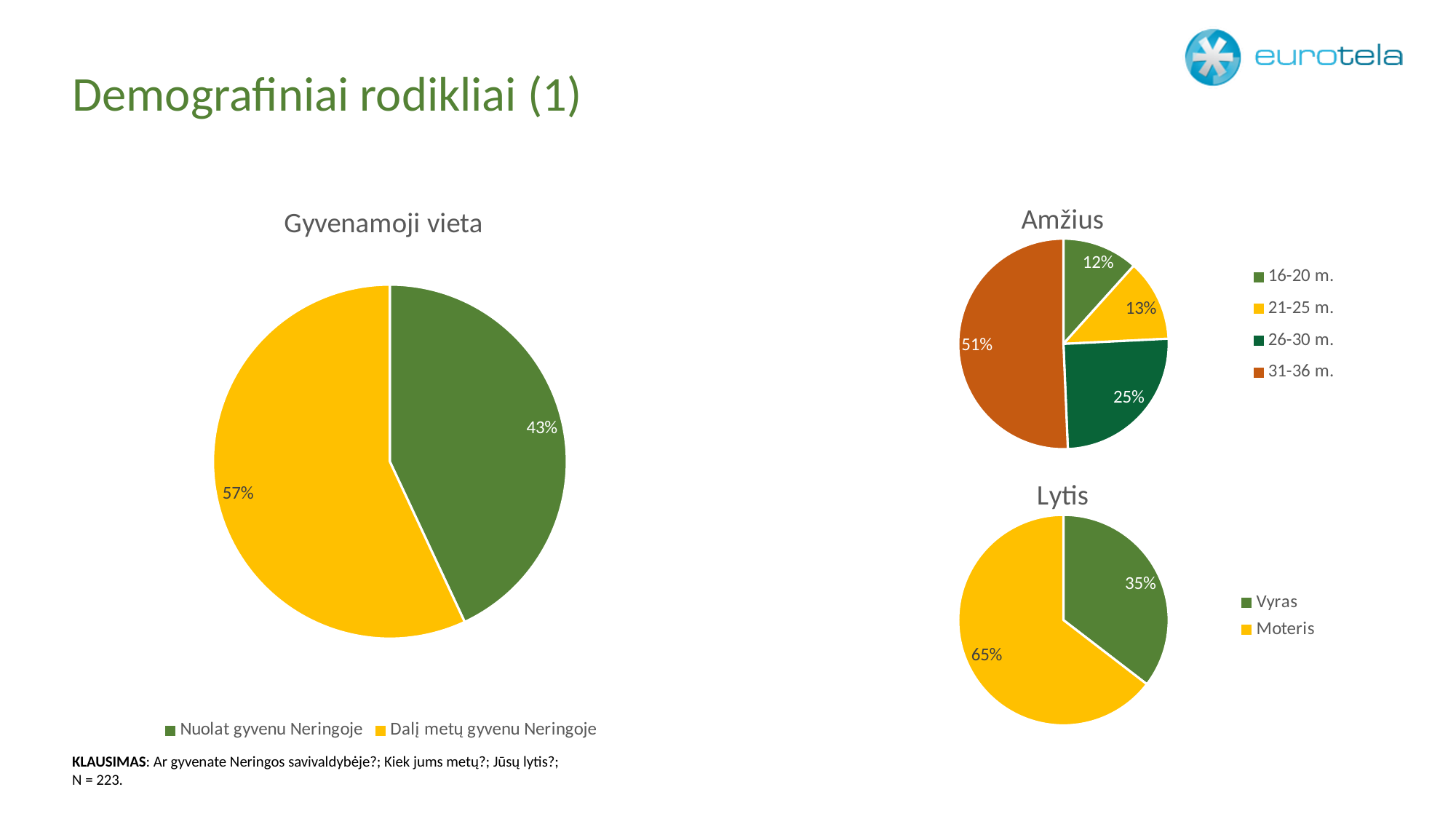
In the 'Gyvenamoji vieta' chart, what is the difference between the two slices' percentages? 14% In the 'Amžius' chart, which age group has the largest share? 31-36 m. In the 'Amžius' chart, what share is labelled for '26-30 m.'? 25% In the 'Lytis' chart, what share is labelled for 'Moteris'? 65% In the 'Gyvenamoji vieta' chart, what share is labelled for 'Dalį metų gyvenu Neringoje'? 57% In the 'Amžius' chart, which age group has the smallest share? 16-20 m. In the 'Gyvenamoji vieta' chart, which category has the larger share? Dalį metų gyvenu Neringoje In the 'Amžius' chart, how many age groups are shown? 4 In the 'Lytis' chart, which is larger, the share for 'Vyras' or for 'Moteris'? Moteris In the 'Amžius' chart, what is the difference between the shares for '31-36 m.' and '21-25 m.'? 38% What kind of chart is the 'Lytis' chart? Pie chart In the 'Gyvenamoji vieta' chart, what share is labelled for 'Nuolat gyvenu Neringoje'? 43%